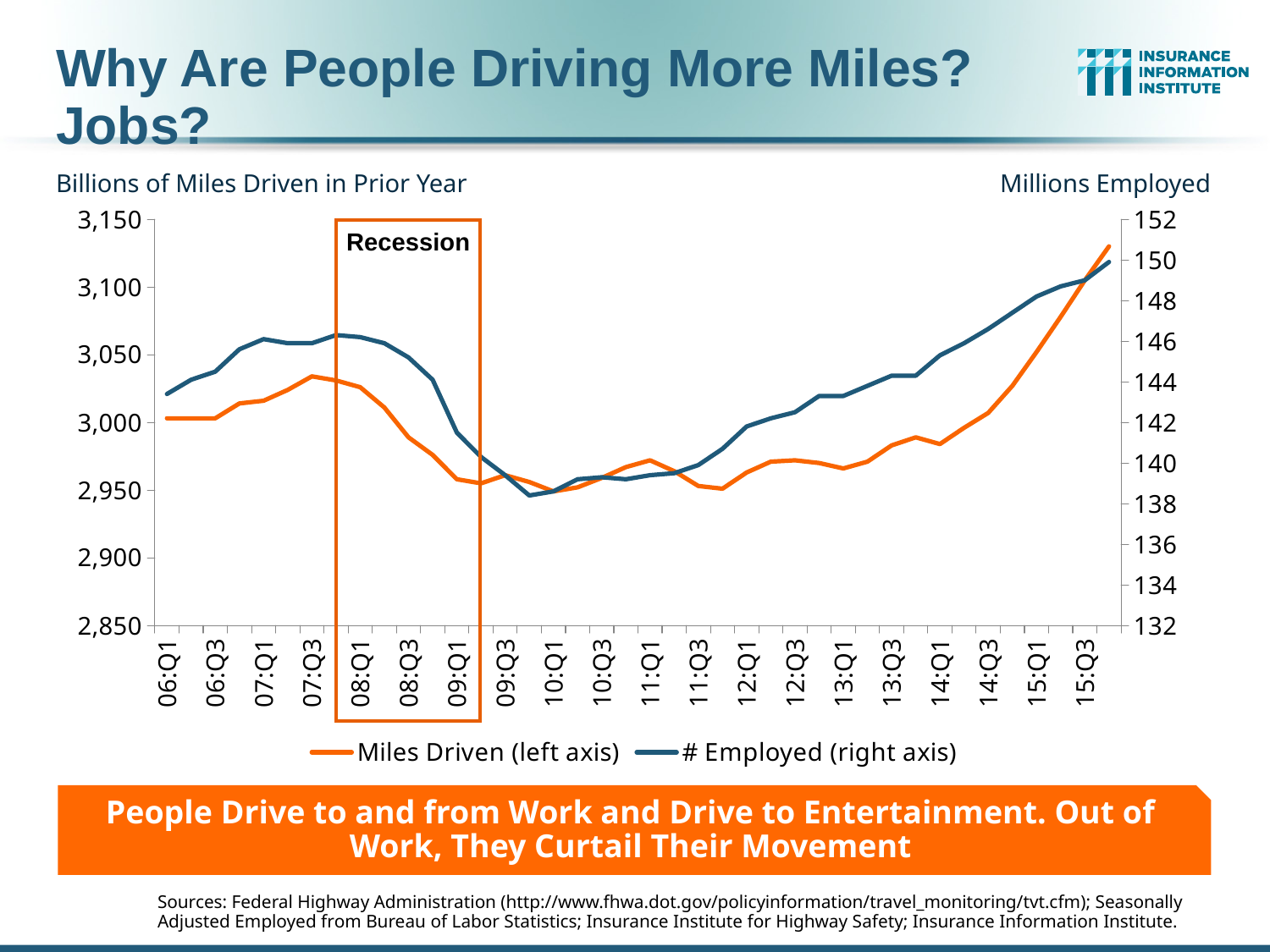
How many series does the legend list? 2 What label is shown inside the highlighted box over 08:Q1 to 09:Q1? Recession Is the value for # Employed at 09:Q3 greater or less than 140? less At which quarter does the Miles Driven series reach its highest value? 15:Q4 What are the two series named in the legend? Miles Driven (left axis) and # Employed (right axis) Does the Miles Driven series rise or fall from 13:Q1 to 15:Q3? Rise Is the value for # Employed at 15:Q3 greater or less than 148? greater Does the # Employed series rise or fall from 08:Q1 to 09:Q3? Fall Is the value for # Employed at 08:Q1 greater or less than 144? greater What kind of chart is shown on the slide? Line chart